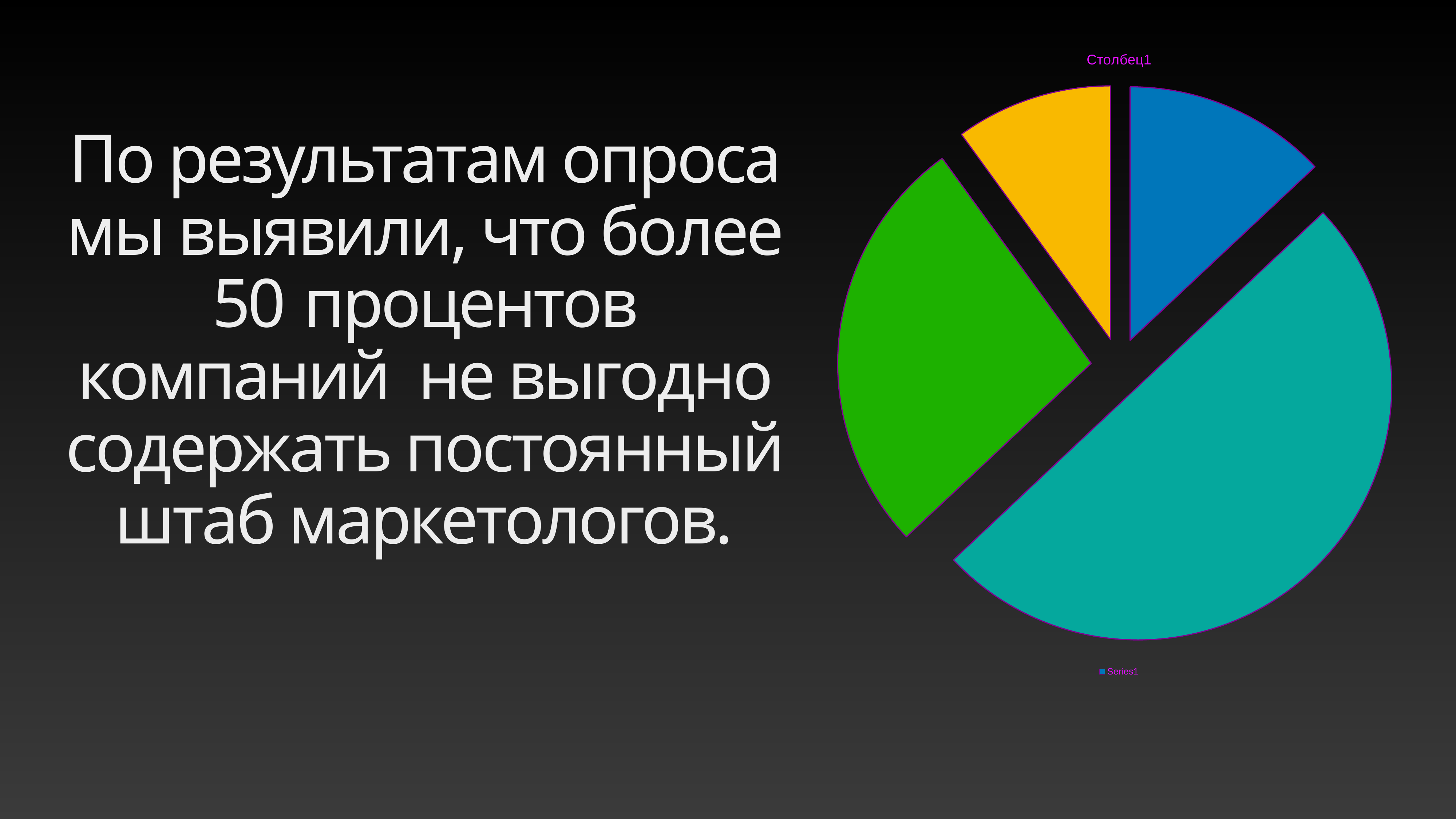
Which is larger in the pie chart, the green slice or the yellow slice? the green slice How many slices does the pie chart have? 4 Which is larger in the pie chart, the teal slice or the green slice? the teal slice Which slice of the pie chart is the largest? the teal slice What kind of chart is shown on the slide? pie chart How many series does the legend of the pie chart list? 1 What is the legend entry shown below the pie chart? Series1 What is the title of the pie chart? Столбец1 Which is larger in the pie chart, the green slice or the blue slice? the green slice